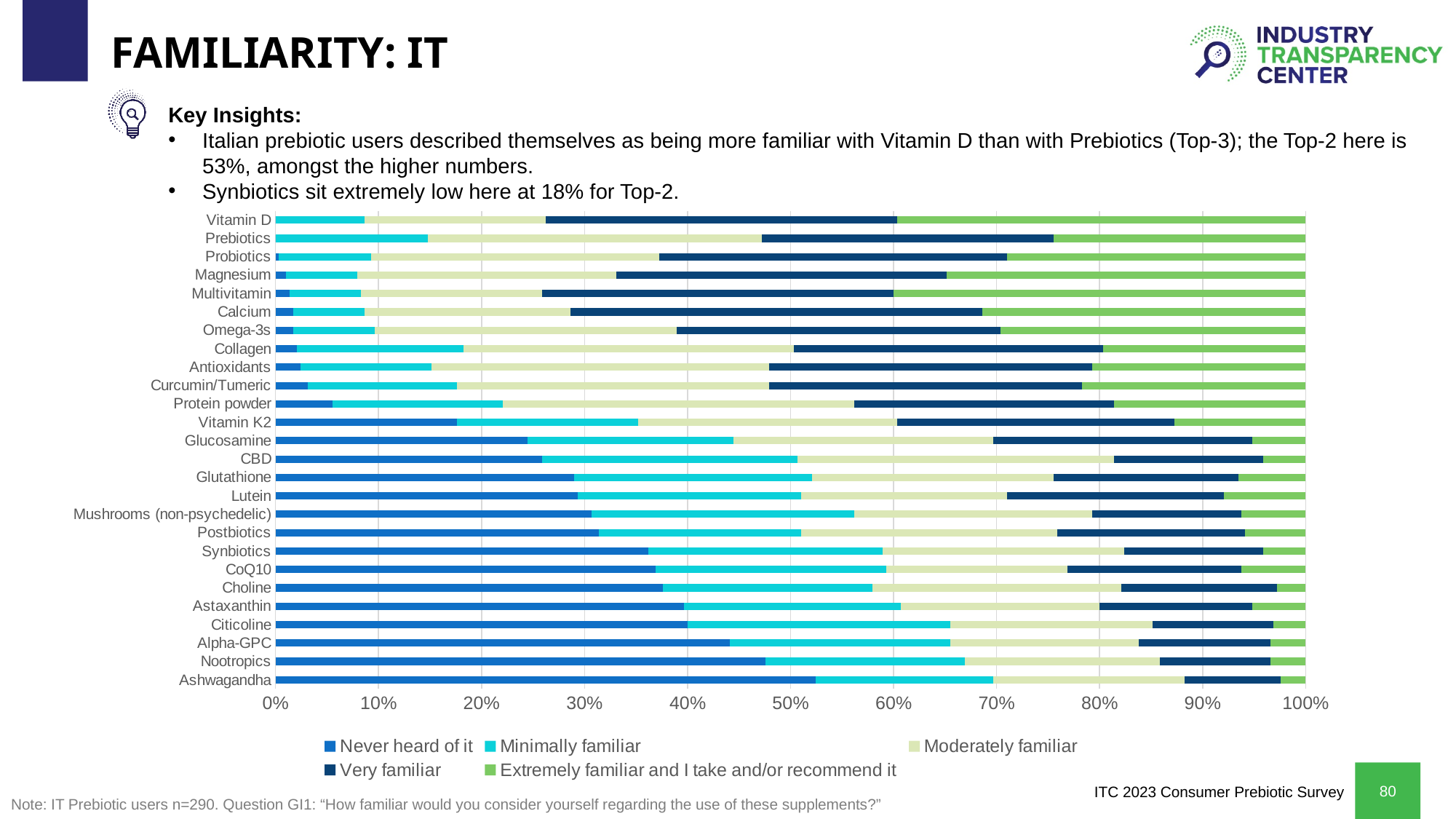
How many supplement categories are listed on the chart? 26 Which has a larger 'Never heard of it' share, Ashwagandha or Vitamin D? Ashwagandha Is the 'Never heard of it' value for Vitamin K2 greater or less than 20%? less How many series does the chart legend list? 5 Is the 'Never heard of it' value for Alpha-GPC greater or less than 40%? greater Which supplement has the largest 'Never heard of it' share? Ashwagandha Is the 'Never heard of it' value for Ashwagandha greater or less than 50%? greater Which has a larger 'Extremely familiar and I take and/or recommend it' share, Vitamin D or Ashwagandha? Vitamin D Moving down the list from Vitamin D to Ashwagandha, does the 'Never heard of it' share generally rise or fall? Rise What kind of chart is shown on the slide? Stacked bar chart Which legend entry is shown in dark blue at the left end of each bar? Never heard of it